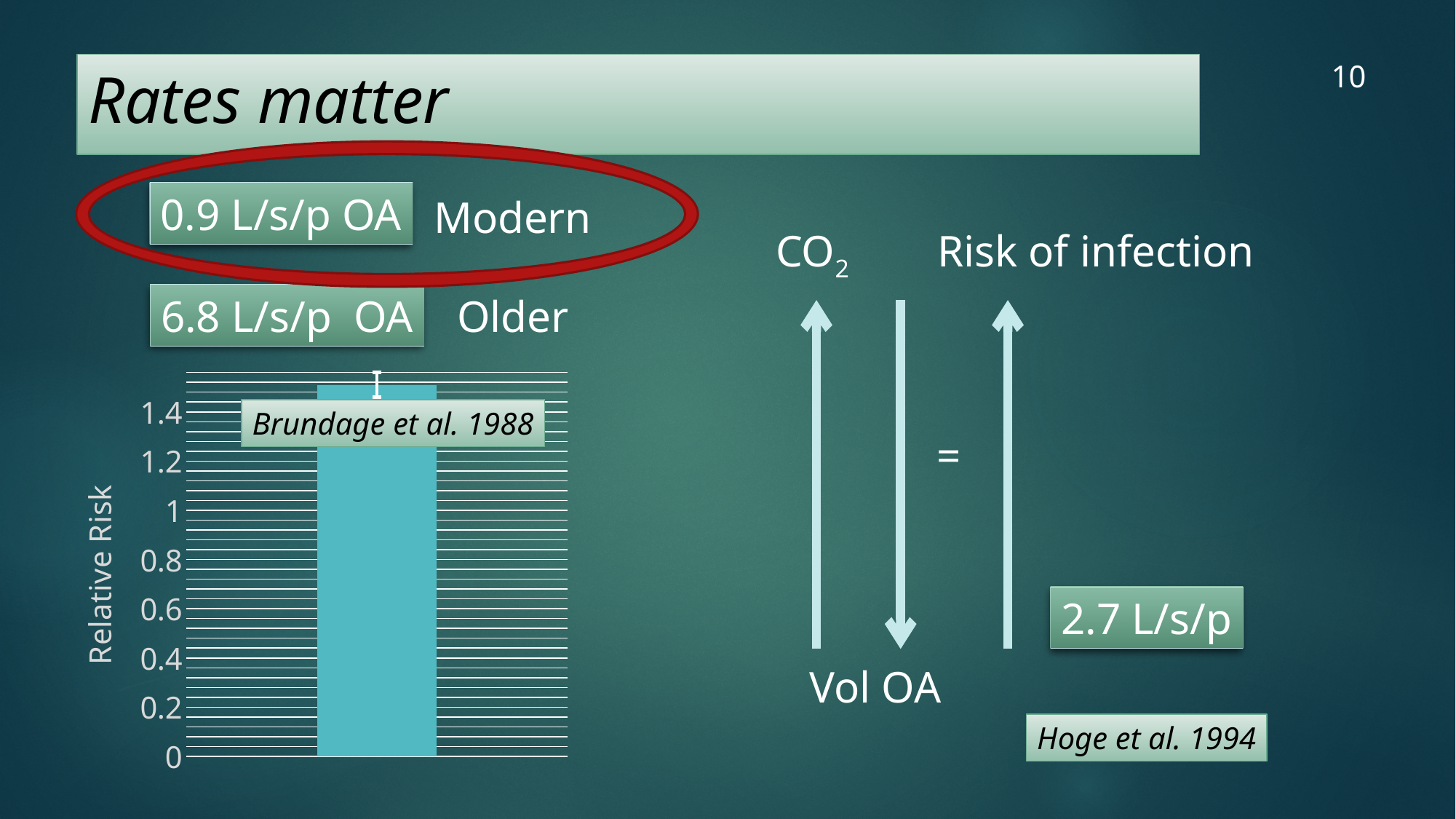
Is the value of the bar in the chart greater or less than 0.8? greater What citation is shown in the text box overlaid on the chart? Brundage et al. 1988 What is the label on the vertical axis of the chart? Relative Risk Is the value of the bar in the chart greater or less than 1? greater Is the value of the bar in the chart greater or less than 1.4? greater How many bars are plotted in the chart? 1 What kind of chart is shown on the slide? bar chart